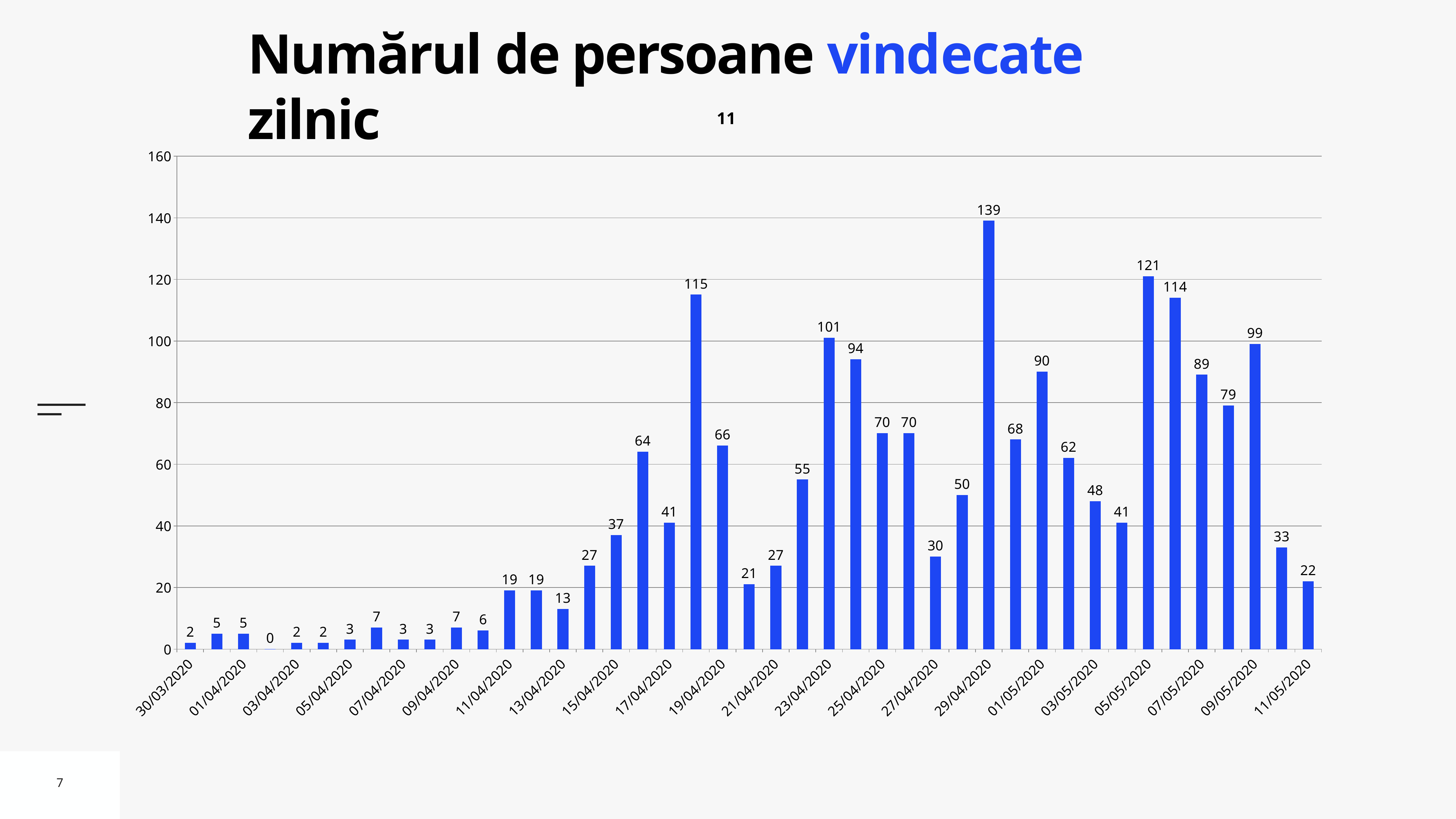
Which date has the highest value? 29/04/2020 What is the value for 29/04/2020? 139 Do the values generally rise or fall from 30/03/2020 to 29/04/2020? rise Is the value for 23/04/2020 greater or less than 100? greater What is the value for 23/04/2020? 101 Which is larger, the value for 01/05/2020 or the value for 07/05/2020? 01/05/2020 What is the difference between the values for 29/04/2020 and 05/05/2020? 18 What type of chart is shown on the slide? bar chart What is the title of the slide? Numărul de persoane vindecate zilnic What is the value for 05/05/2020? 121 What is the difference between the values for 09/05/2020 and 11/05/2020? 77 What is the value for 11/05/2020? 22